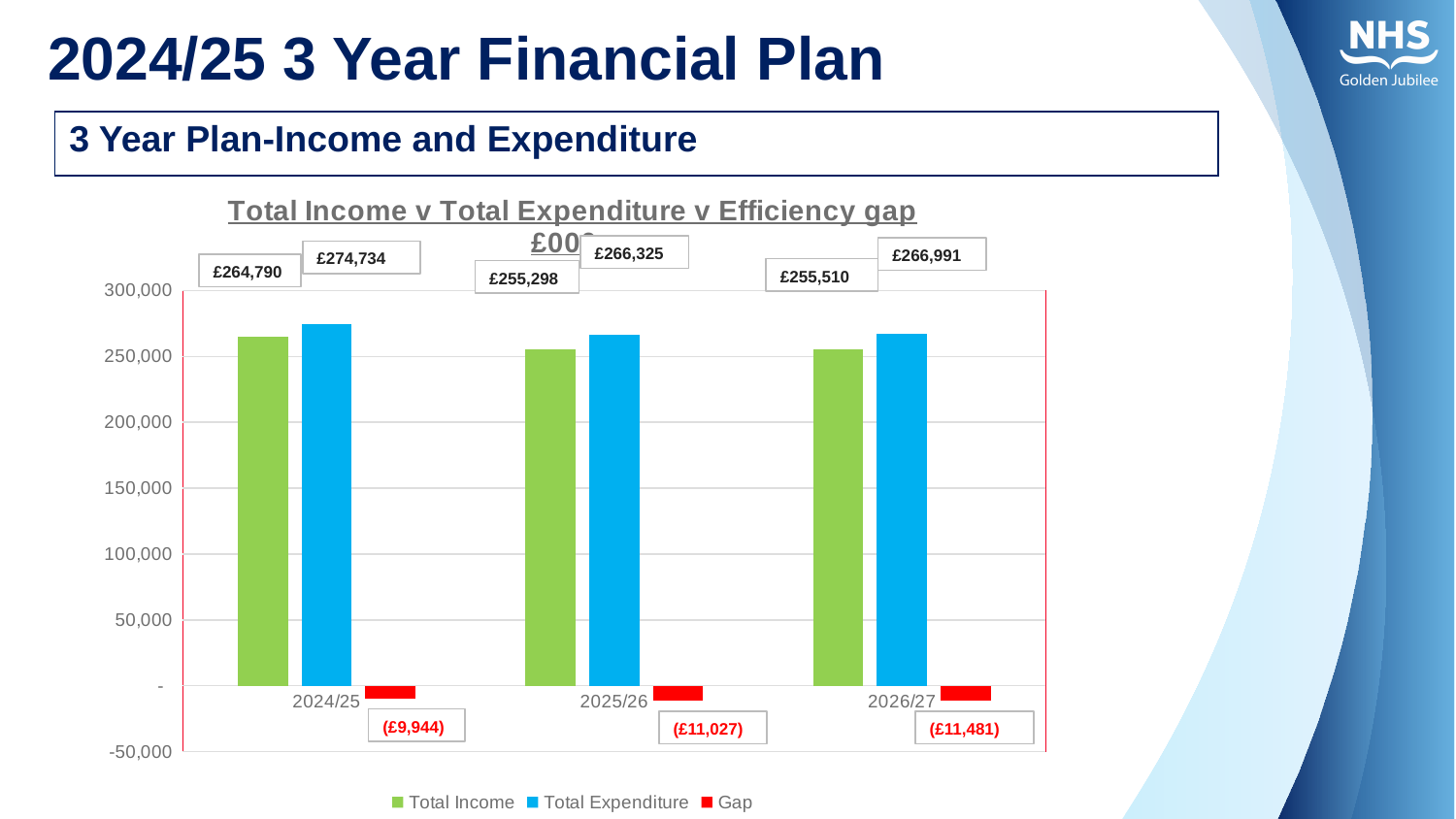
Which year has the lowest Total Income? 2025/26 Is Total Expenditure in 2025/26 larger or smaller than Total Income in 2025/26? larger What is the Total Income for 2024/25? £264,790 Is the Total Income for 2026/27 greater or less than 250,000? greater What is the difference between Total Expenditure and Total Income in 2024/25? £9,944 What kind of chart is shown on the slide? bar chart How many series does the legend list? 3 What is the Total Expenditure for 2026/27? £266,991 What is the Gap value shown for 2025/26? (£11,027) How many years are shown on the x axis? 3 Which colour represents Total Expenditure in the legend? blue Which year has the highest Total Income? 2024/25